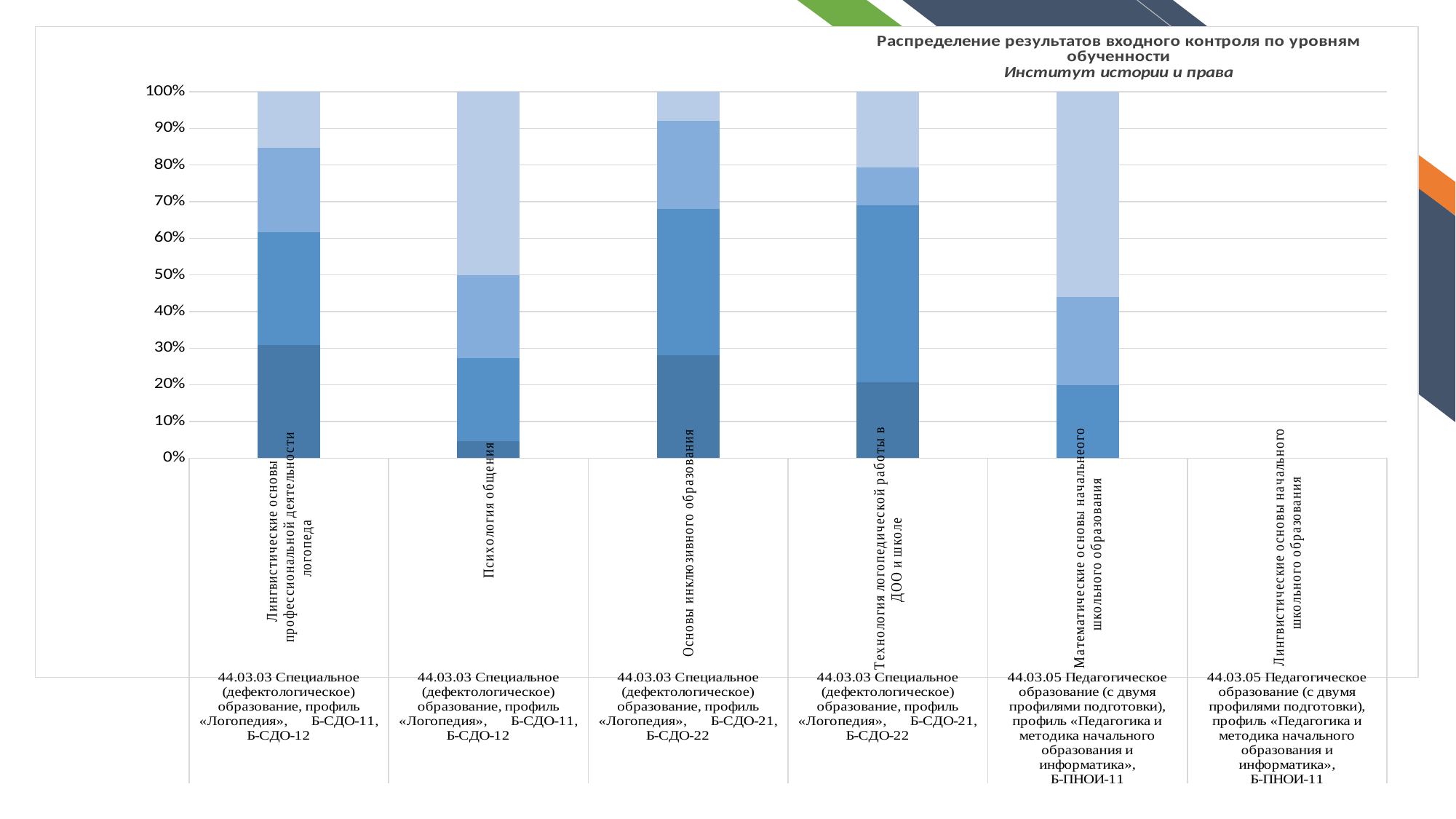
Is the darkest (bottom) segment for Лингвистические основы профессиональной деятельности логопеда greater or less than 20%? greater How many of the categories on the x axis actually have a bar plotted? 5 Is the darkest (bottom) segment for Психология общения greater or less than 10%? less Which category has no bar plotted at all? Лингвистические основы начального школьного образования What kind of chart is shown on the slide? Stacked bar chart Is the lightest (top) segment for Математические основы начального образования greater or less than 50%? greater How many categories (disciplines) are listed along the x axis of the chart? 6 Which has the larger darkest (bottom) segment: Лингвистические основы профессиональной деятельности логопеда or Психология общения? Лингвистические основы профессиональной деятельности логопеда Which institute is named in the chart's subtitle? Институт истории и права What is the title of the chart? Распределение результатов входного контроля по уровням обученности